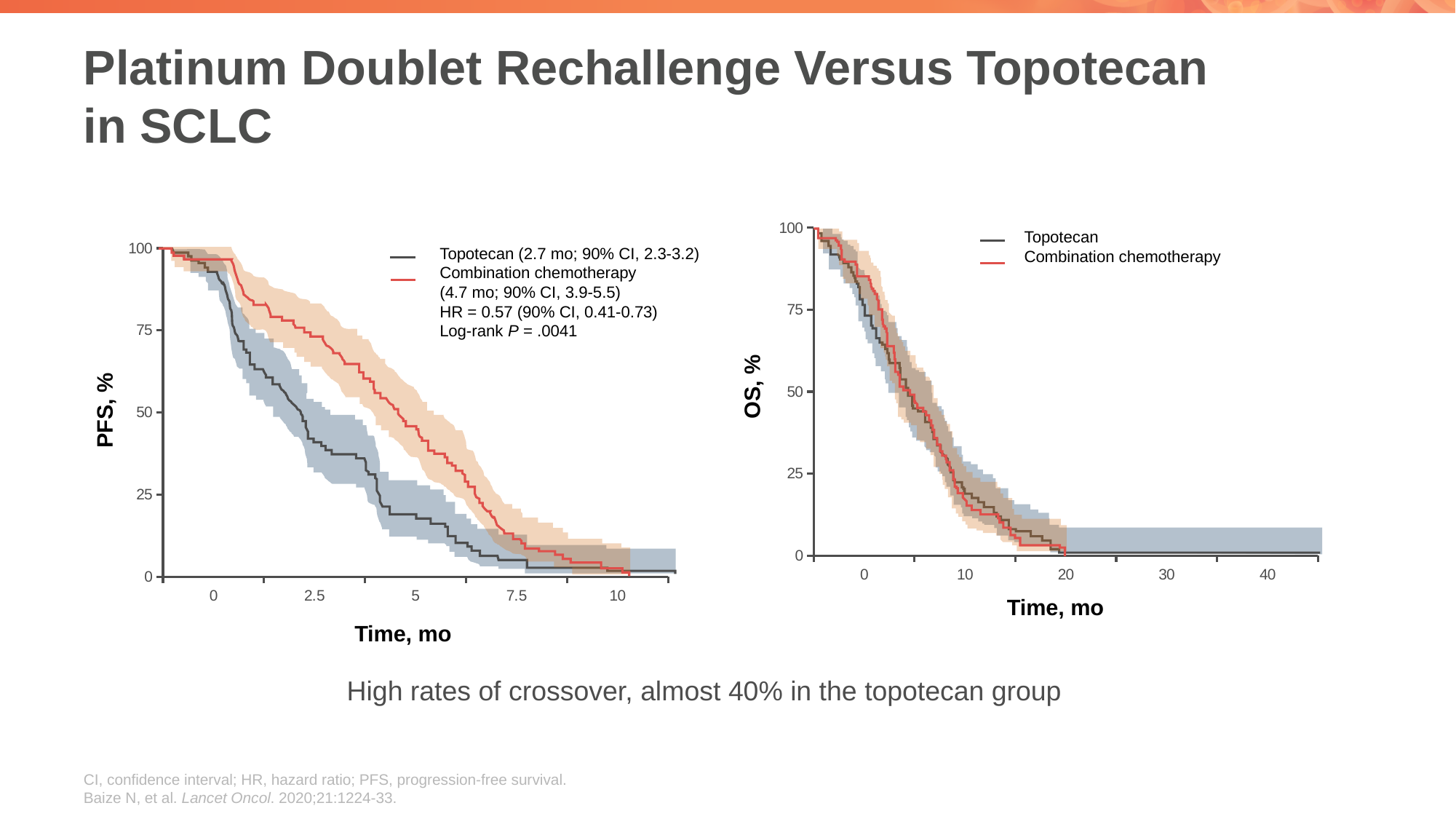
In the right chart (OS, %), what colour is the Combination chemotherapy line? red In the left chart (PFS, %), is the Combination chemotherapy PFS at 2.5 months greater or less than 50%? greater In the left chart (PFS, %), which group has the longer median PFS, Topotecan or Combination chemotherapy? Combination chemotherapy In the right chart, what is the label on the y axis? OS, % In the left chart (PFS, %), what hazard ratio (HR) is shown in the legend? 0.57 In the left chart (PFS, %), how many series does the legend list? 2 In the left chart (PFS, %), do the survival curves rise or fall as time increases? fall In the left chart (PFS, %), what is the difference in median PFS between Combination chemotherapy and Topotecan? 2.0 mo In the left chart (PFS, %), what log-rank P value is shown? .0041 In the left chart (PFS, %), what median PFS is given in the legend for Topotecan? 2.7 mo In the left chart (PFS, %), what median PFS is given in the legend for Combination chemotherapy? 4.7 mo What kind of chart is the left chart (PFS, %)? line chart